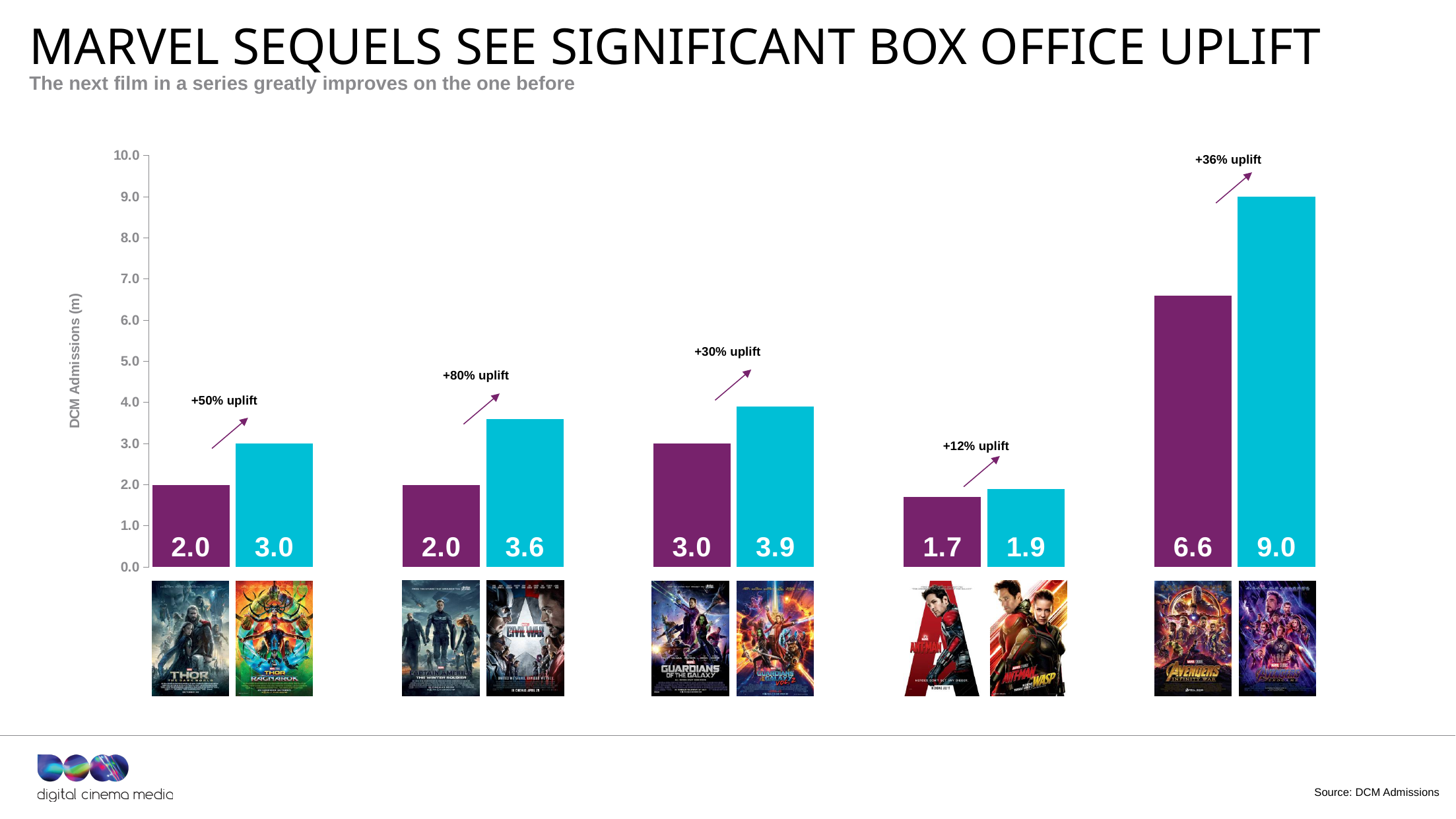
Which bar has the lowest value on the chart? the purple bar in the pair labelled '+12% uplift' (1.7) What is the value of the blue bar in the pair labelled '+12% uplift'? 1.9 What is the value of the blue bar in the rightmost pair of bars? 9.0 What is the label of the vertical axis? DCM Admissions (m) What is the difference between the two bars in the rightmost pair? 2.4 How many pairs of bars are shown on the chart? 5 What is the value of the blue bar in the leftmost pair of bars? 3.0 Which bar has the highest value on the chart? the blue bar in the rightmost pair (9.0) What is the value of the purple bar in the pair labelled '+30% uplift'? 3.0 What is the value of the purple bar in the leftmost pair of bars? 2.0 What is the value of the blue bar in the pair labelled '+80% uplift'? 3.6 What kind of chart is shown on the slide? bar chart